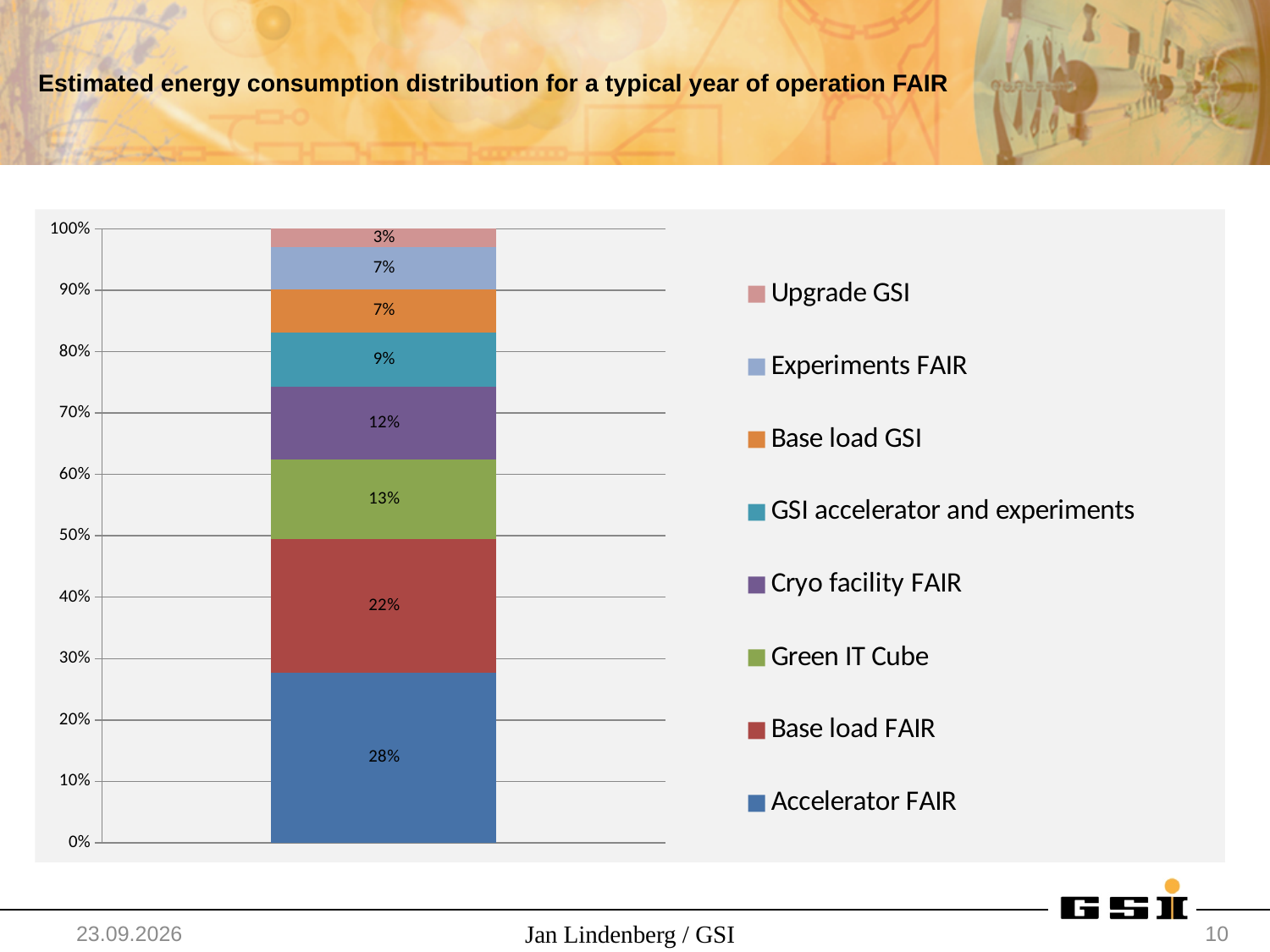
What is the value shown for Cryo facility FAIR? 12% What is the value shown for Green IT Cube? 13% Which series has the largest share of the stacked bar? Accelerator FAIR What share of the estimated energy consumption is attributed to Accelerator FAIR? 28% What is the difference between the Accelerator FAIR share and the Base load FAIR share? 6% What kind of chart is shown on the slide? Stacked bar chart What is the value shown for Base load FAIR? 22% How many series does the legend list? 8 What is the value shown for Upgrade GSI? 3% What is the value shown for GSI accelerator and experiments? 9% Which series has the smallest share of the stacked bar? Upgrade GSI Which is larger, the share for Green IT Cube or the share for Cryo facility FAIR? Green IT Cube